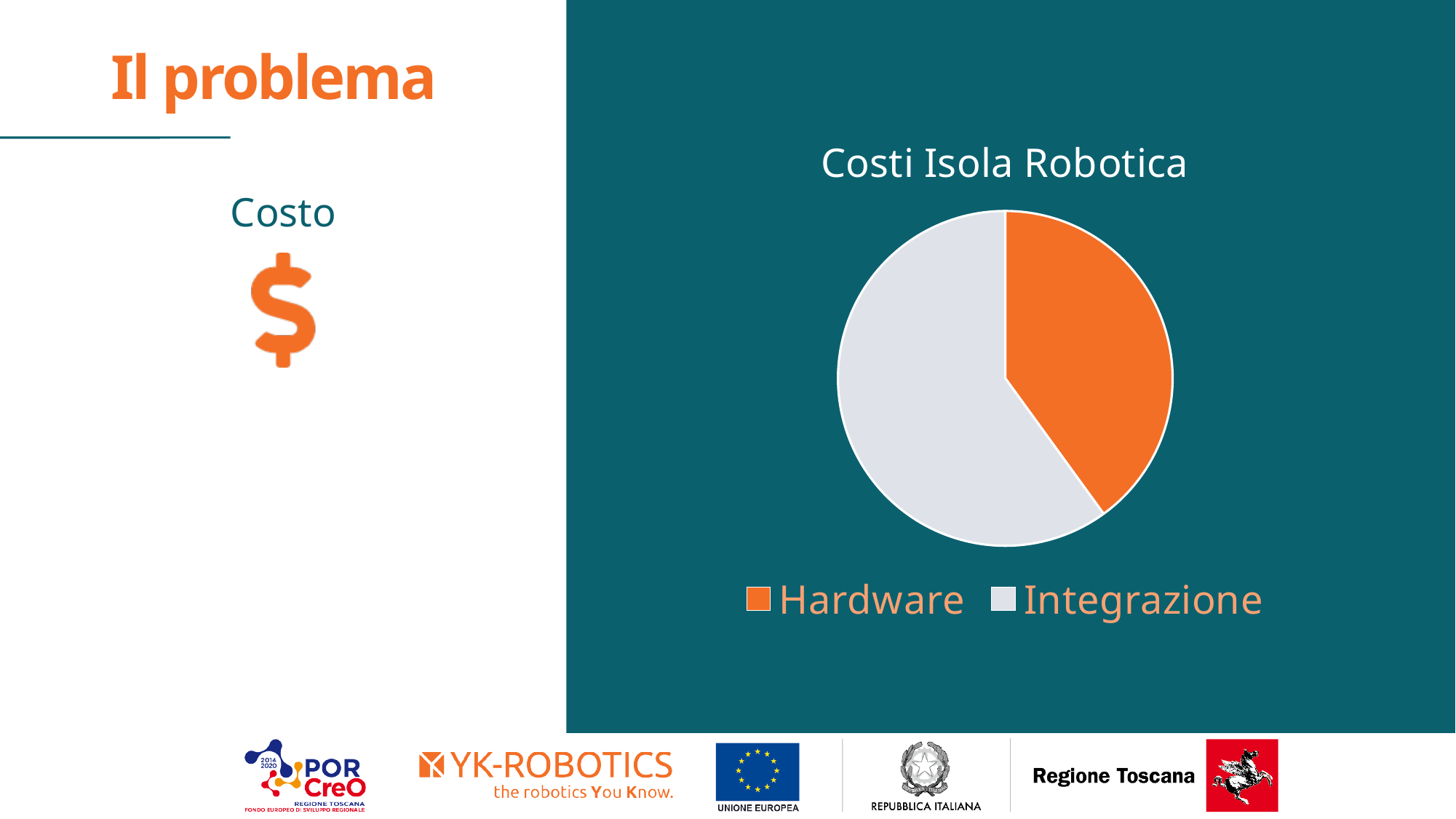
Which category has the smallest slice of the pie? Hardware Which is larger, the Hardware slice or the Integrazione slice? Integrazione What is the title of the chart? Costi Isola Robotica How many entries does the chart's legend list? 2 Which colour represents Hardware in the pie chart? orange How many slices does the pie chart have? 2 Which category has the largest slice of the pie? Integrazione What kind of chart is shown on the slide? pie chart